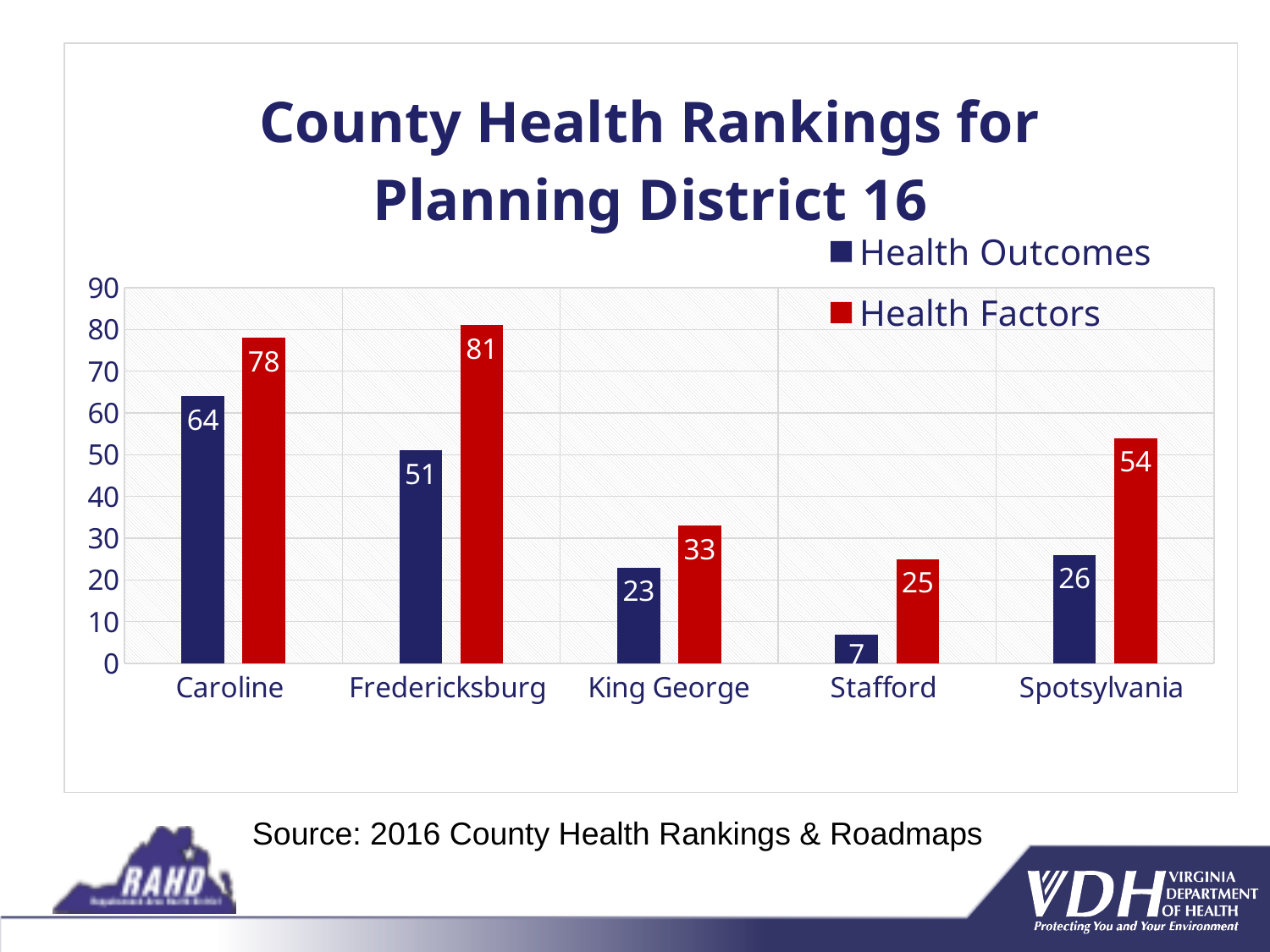
What is the difference between the Health Factors and Health Outcomes values for Spotsylvania? 28 What is the Health Outcomes value for Stafford? 7 Is the Health Factors value for Caroline greater or less than 70? greater What is the Health Outcomes value for Caroline? 64 What is the Health Factors value for Fredericksburg? 81 What colour are the Health Factors bars? Red Which county has the highest Health Factors value? Fredericksburg How many counties are shown on the x axis? 5 What kind of chart is shown on the slide? Bar chart Which county has the lowest Health Outcomes value? Stafford Which is larger for King George: Health Outcomes or Health Factors? Health Factors How many series does the legend list? 2